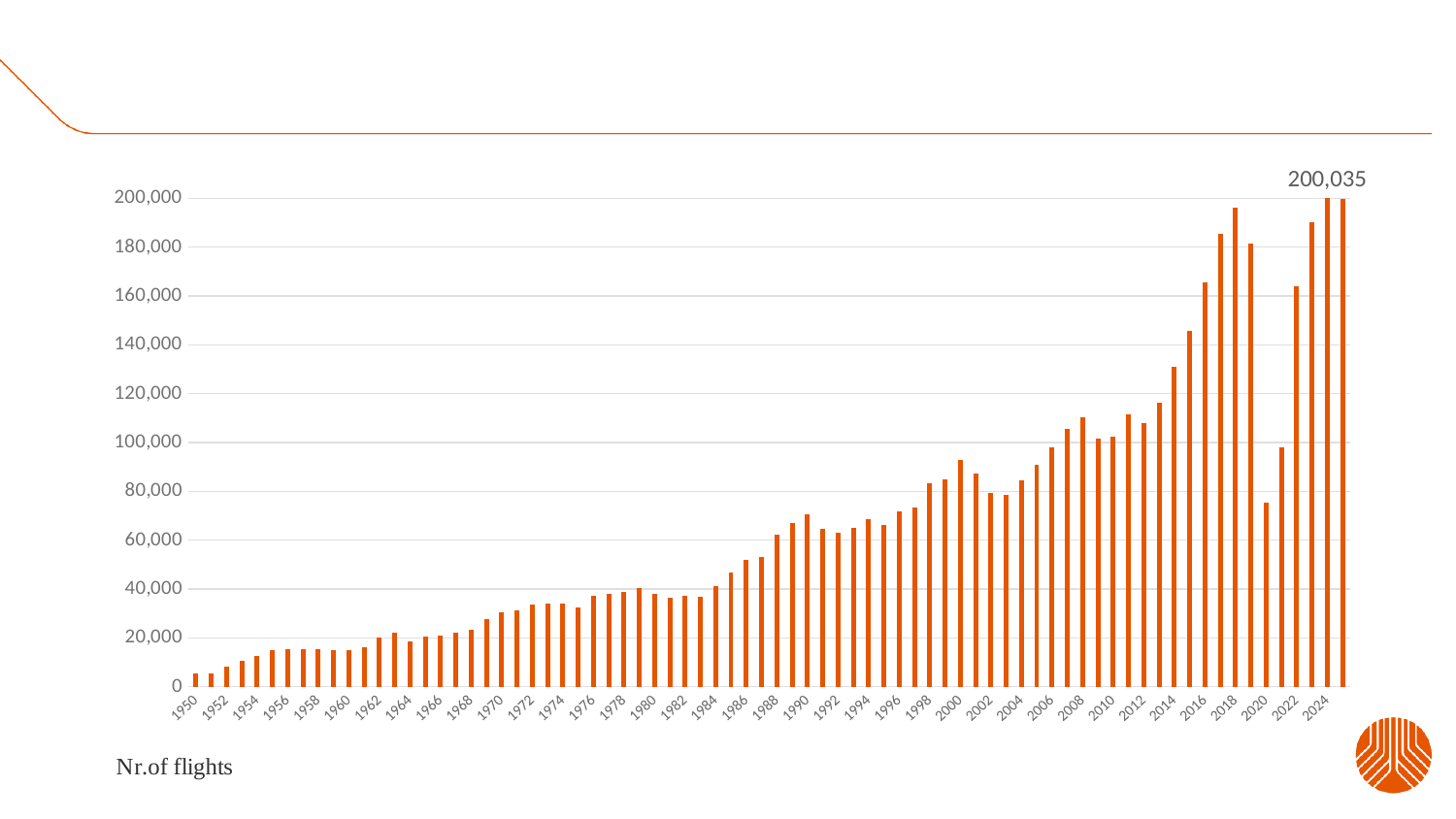
Which year has more flights, 2017 or 2018? 2018 Do the values generally rise or fall from 1950 to 2024? rise Is the value for 2020 greater or less than 80,000? less What label is shown below the chart describing the plotted quantity? Nr.of flights What is the value printed on the data label for the tallest bar? 200,035 Is the value for 2018 greater or less than 180,000? greater What kind of chart is shown on the slide? bar chart Is the value for 1950 greater or less than 20,000? less Which year has the highest number of flights? 2024 Which year has more flights, 2019 or 2020? 2019